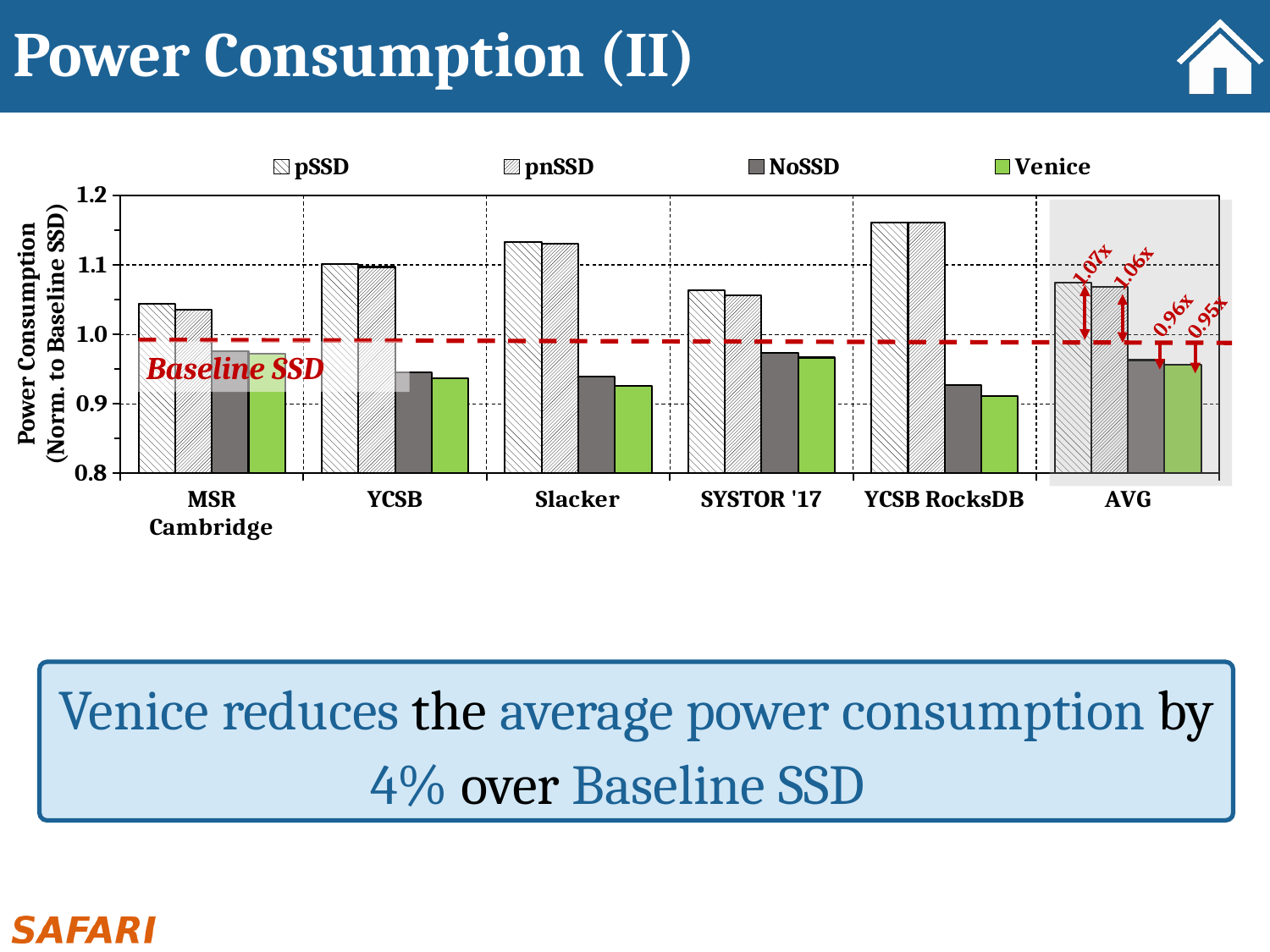
How many series does the legend list? 4 Which workload has the highest pSSD power consumption? YCSB RocksDB How many workload categories are shown on the x axis? 6 What is the annotated value for NoSSD in the AVG category? 0.96x Is the pSSD value for YCSB RocksDB greater or less than 1.1? greater What kind of chart is shown on the slide? bar chart What is the annotated value for pnSSD in the AVG category? 1.06x Which is larger, the pSSD value for Slacker or the pSSD value for SYSTOR '17? Slacker Is the Venice value for Slacker greater or less than 1.0? less What does the red dashed horizontal line represent? Baseline SSD What is the annotated value for pSSD in the AVG category? 1.07x What is the annotated value for Venice in the AVG category? 0.95x